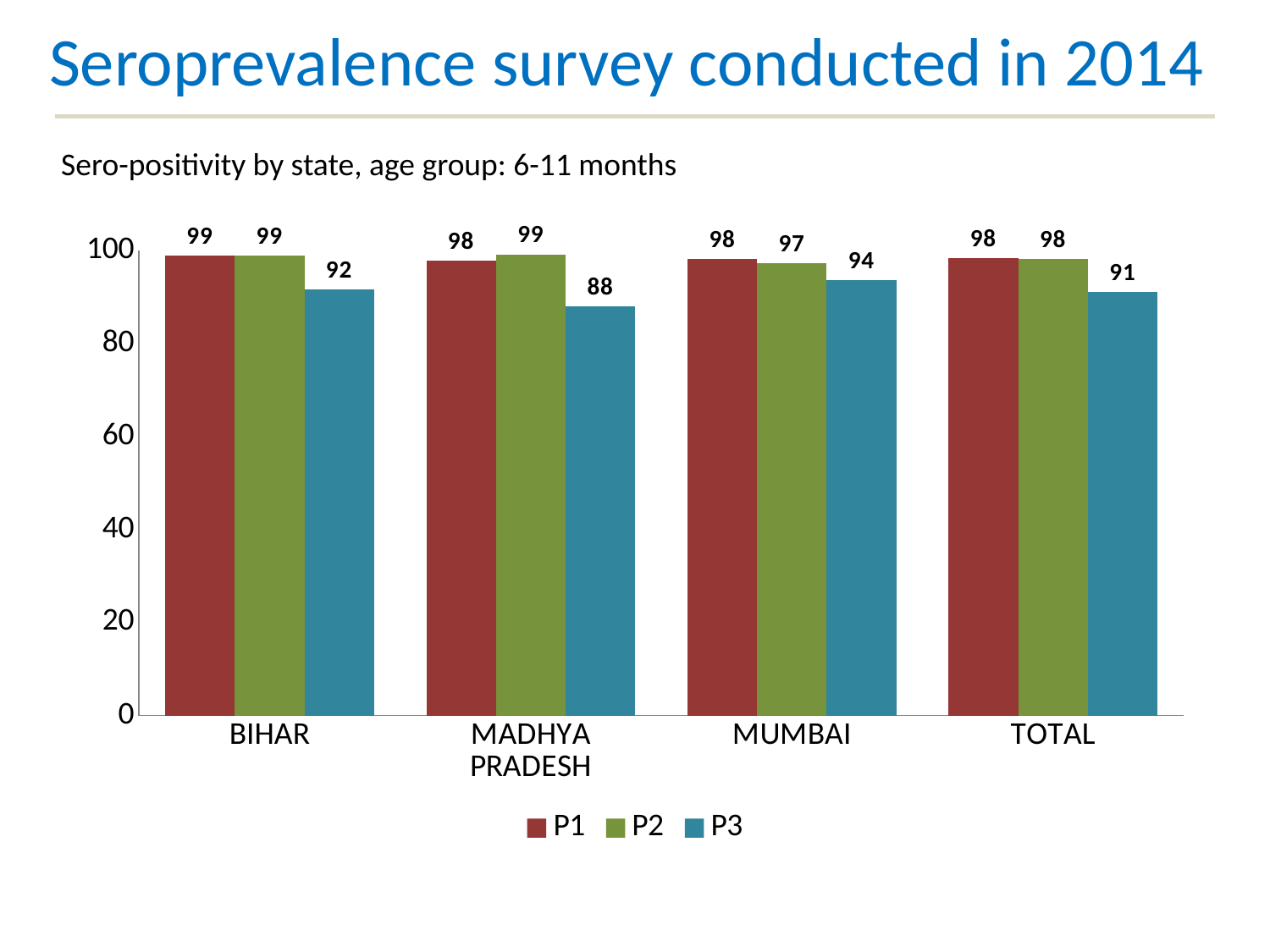
What is the P3 value for BIHAR? 92 What is the P3 value for MADHYA PRADESH? 88 What kind of chart is shown on the slide? bar chart What is the P2 value for TOTAL? 98 What is the P1 value for MUMBAI? 98 Which is larger, the P3 value for BIHAR or the P3 value for MUMBAI? MUMBAI What is the subtitle of the chart? Sero-positivity by state, age group: 6-11 months Which category has the lowest P3 value? MADHYA PRADESH Which category has the highest P3 value? MUMBAI What is the difference between the P2 and P3 values for MADHYA PRADESH? 11 How many series does the legend list? 3 How many categories are shown on the x axis? 4